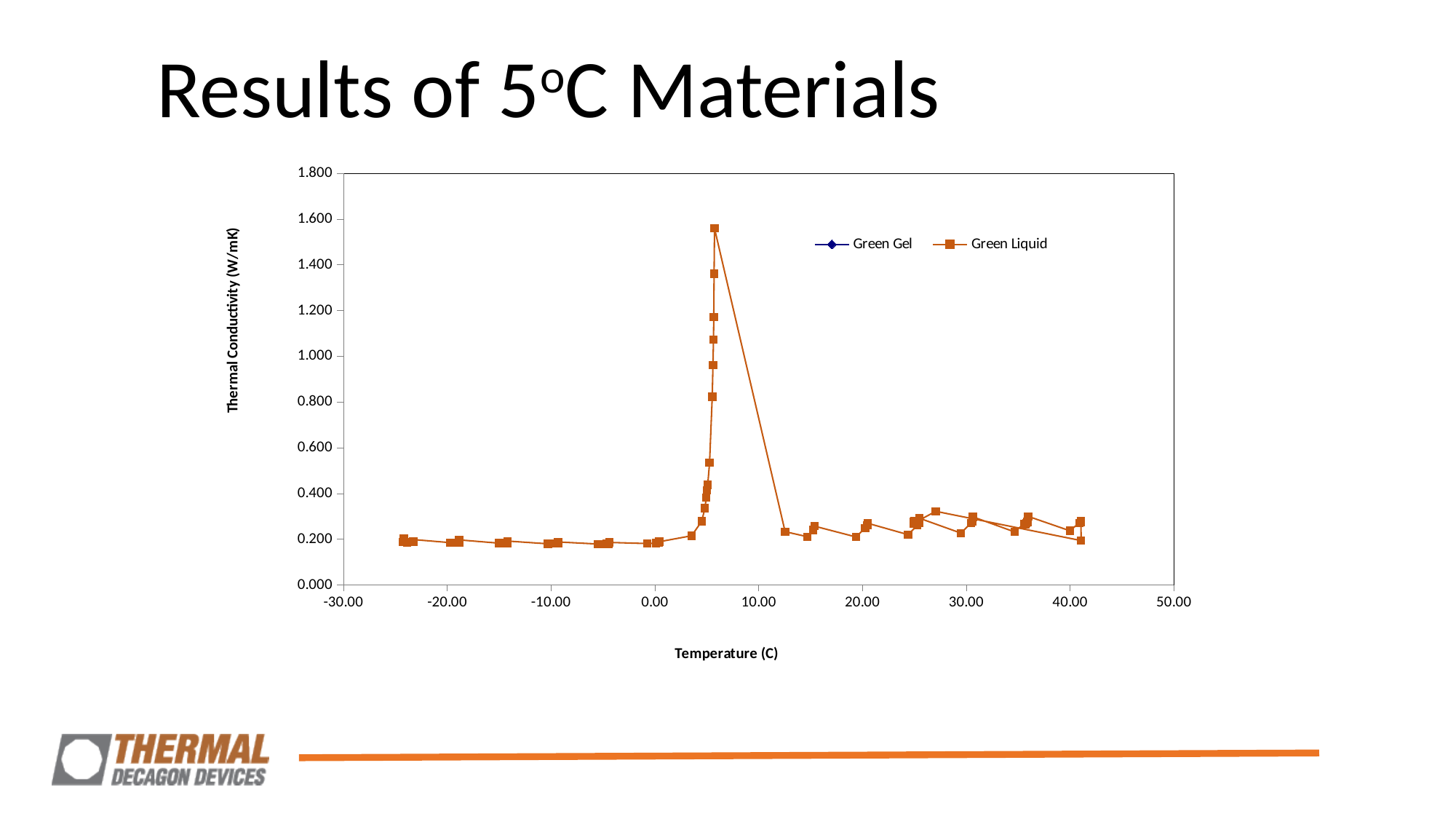
Is the peak value of the Green Liquid series greater or less than 1.600? less Between the peak near 5.00 C and about 12.00 C, do the Green Liquid values rise or fall? fall What kind of chart is shown on the slide? line chart What are the two series named in the legend? Green Gel and Green Liquid Is the Green Liquid value at about -20.00 C greater or less than 0.400? less Between about 0.00 C and 5.00 C, do the Green Liquid values rise or fall? rise Is the peak value of the Green Liquid series greater or less than 1.400? greater How many series does the legend list? 2 What is the maximum value shown on the y axis? 1.800 Which is larger for Green Liquid: the value at the peak near 5.00 C or the value at about 20.00 C? the peak near 5.00 C What is the label of the y axis? Thermal Conductivity (W/mK)